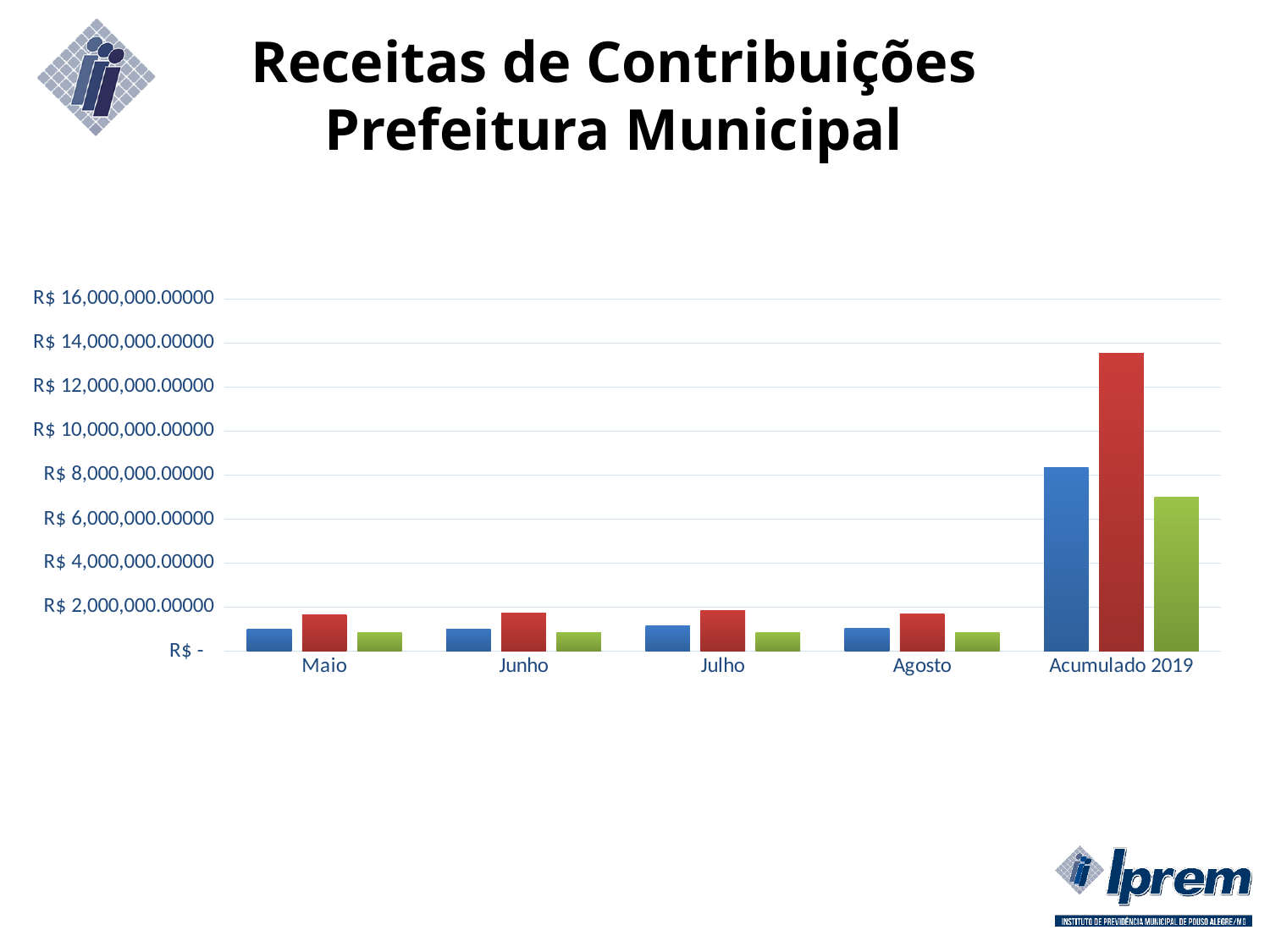
In the Acumulado 2019 category, which is larger, the blue bar or the green bar? the blue bar How many categories are shown on the x axis of the chart? 5 Is the value of the red bar for Acumulado 2019 greater or less than R$ 12,000,000.00000? greater Which category on the x axis has the tallest bars? Acumulado 2019 Which coloured bar is the tallest in the Acumulado 2019 category? the red bar Is the value of the red bar for Julho greater or less than R$ 2,000,000.00000? less What kind of chart is shown on the slide? bar chart Is the value of the green bar for Acumulado 2019 greater or less than R$ 8,000,000.00000? less In the Agosto category, which is larger, the red bar or the green bar? the red bar What is the title of the slide containing the chart? Receitas de Contribuições Prefeitura Municipal How many bars are plotted for each category on the chart? 3